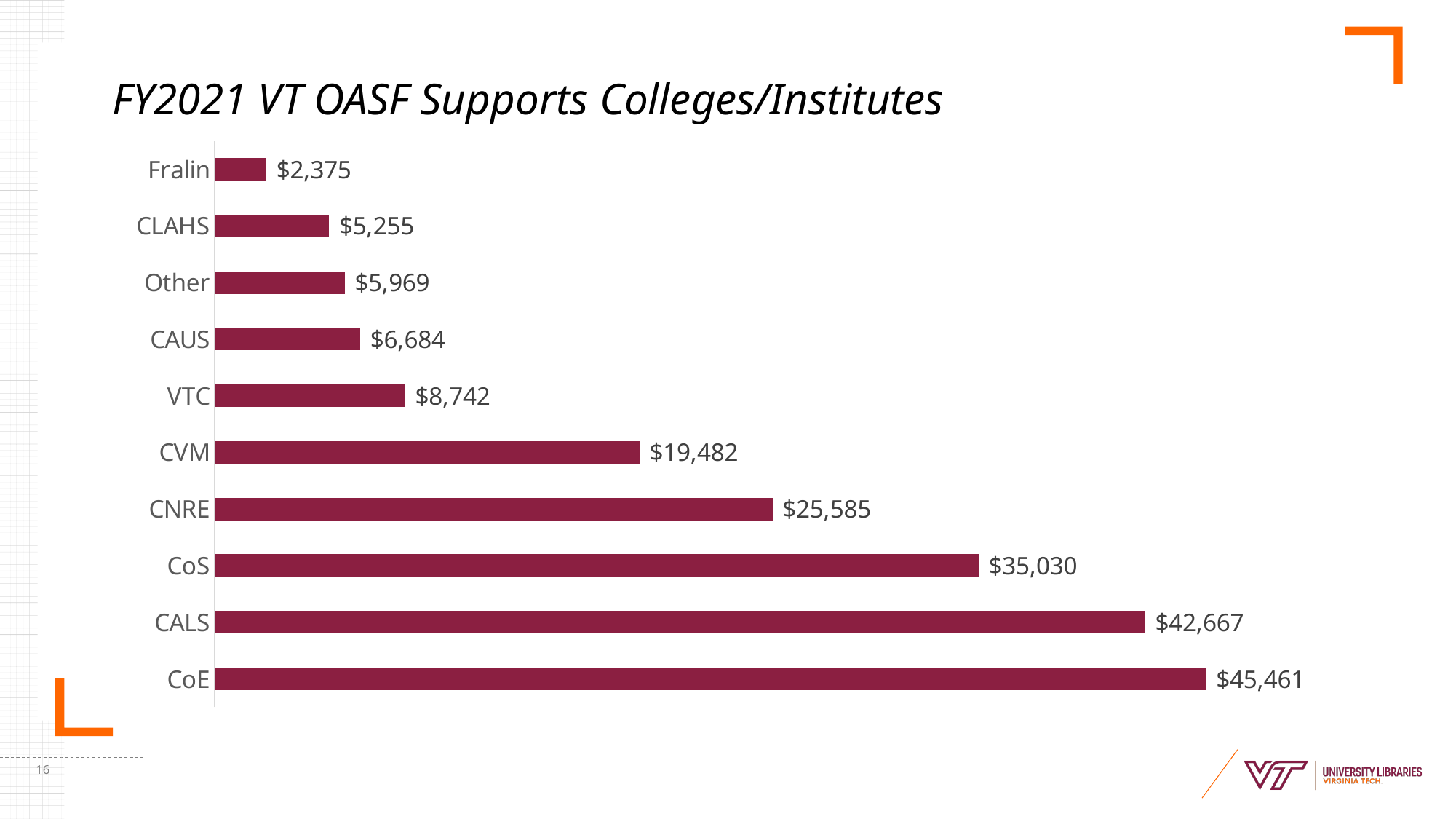
What is the value for Fralin? $2,375 What kind of chart is shown on the slide? Bar chart How many colleges or institutes are shown in the chart? 10 Which college or institute has the lowest value? Fralin What is the difference between the values for CoE and CALS? $2,794 What is the value for CLAHS? $5,255 What is the title of the chart? FY2021 VT OASF Supports Colleges/Institutes What is the value for CVM? $19,482 Which is larger, the value for VTC or the value for CAUS? VTC Which college or institute has the highest value? CoE What is the difference between the values for CoS and CNRE? $9,445 What is the value for CoE? $45,461